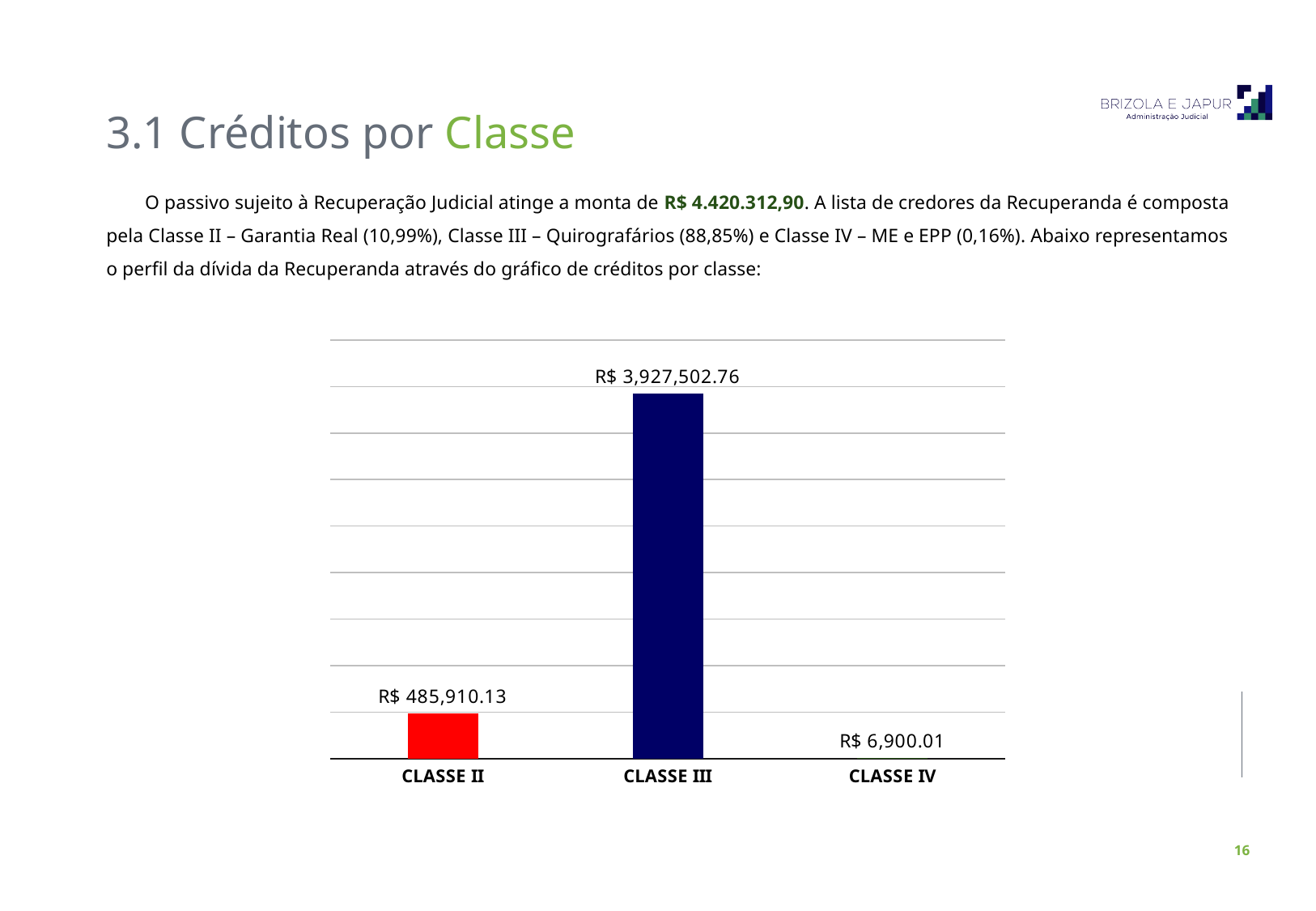
What is the sum of the values of the three bars in the chart? R$ 4,420,312.90 What kind of chart is shown on the slide? Bar chart What colour is the bar for CLASSE II? Red How many classes are shown in the chart? 3 Which class has the highest value in the chart? CLASSE III What is the value shown for CLASSE IV? R$ 6,900.01 Which class has the lowest value in the chart? CLASSE IV What is the value shown for CLASSE II? R$ 485,910.13 What is the value shown for CLASSE III? R$ 3,927,502.76 What is the difference between the values for CLASSE III and CLASSE II? R$ 3,441,592.63 What is the difference between the values for CLASSE II and CLASSE IV? R$ 479,010.12 Which is larger, the value for CLASSE II or the value for CLASSE IV? CLASSE II